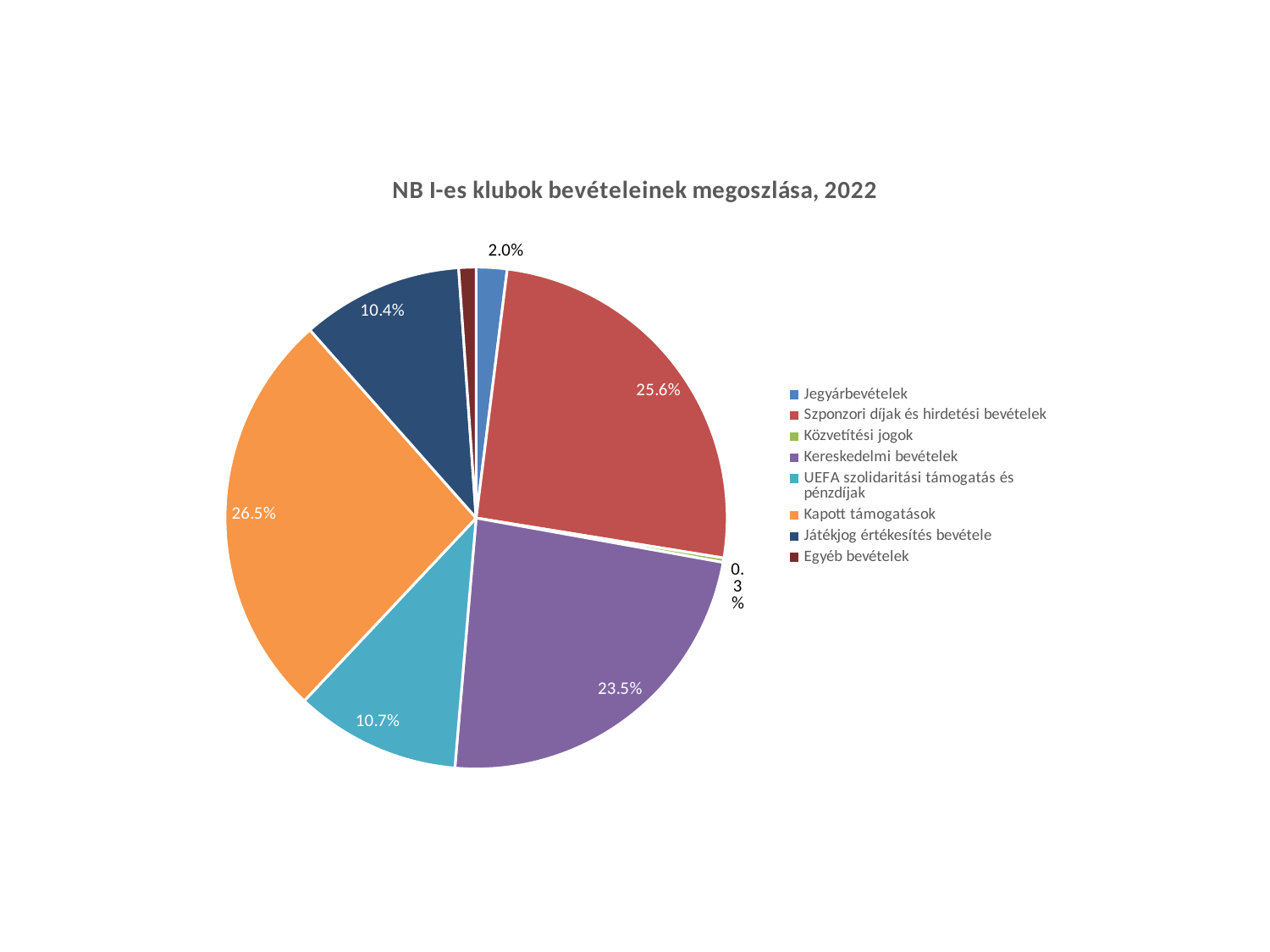
Which is larger: the share for Játékjog értékesítés bevétele or for UEFA szolidaritási támogatás és pénzdíjak? UEFA szolidaritási támogatás és pénzdíjak What percentage does Jegyárbevételek account for? 2.0% What is the title of the chart? NB I-es klubok bevételeinek megoszlása, 2022 What type of chart is shown on the slide? Pie chart What share is shown for UEFA szolidaritási támogatás és pénzdíjak? 10.7% What is the value labelled for Kereskedelmi bevételek? 23.5% Which category has the smallest labelled share of the pie? Közvetítési jogok What is the difference in percentage points between Kapott támogatások and Szponzori díjak és hirdetési bevételek? 0.9 What share of the pie does Szponzori díjak és hirdetési bevételek represent? 25.6% How many categories does the legend list? 8 Which category has the largest share of the pie? Kapott támogatások What percentage is shown for Kapott támogatások? 26.5%